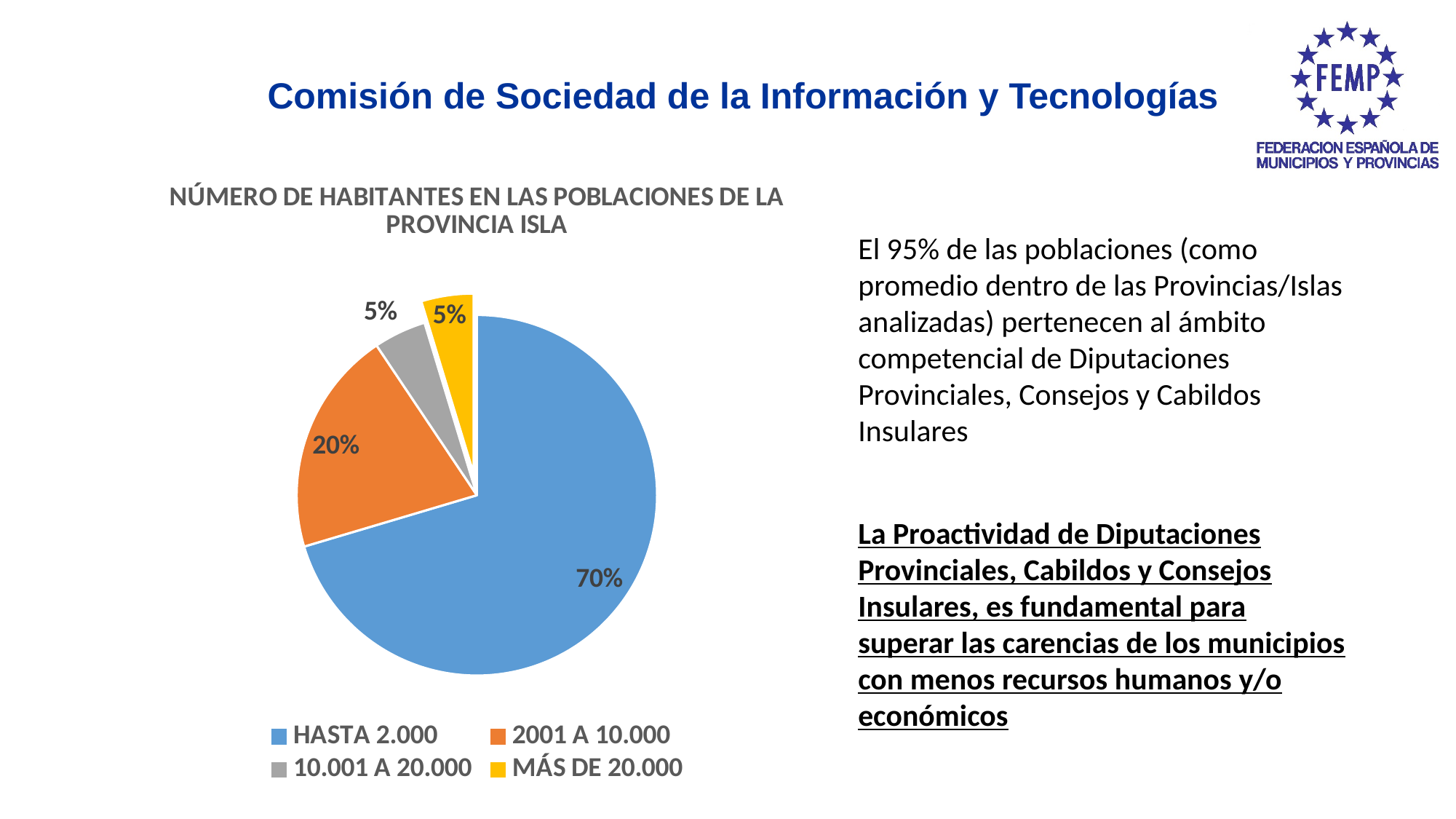
What kind of chart is shown on the slide? Pie chart What is the combined share of HASTA 2.000 and 2001 A 10.000? 90% What share of the pie does 2001 A 10.000 represent? 20% What share of the pie does HASTA 2.000 represent? 70% How many categories does the legend list? 4 What share of the pie does 10.001 A 20.000 represent? 5% Which colour represents MÁS DE 20.000 in the pie chart? Yellow Which is larger, the share for 2001 A 10.000 or the share for MÁS DE 20.000? 2001 A 10.000 What is the title of the chart? NÚMERO DE HABITANTES EN LAS POBLACIONES DE LA PROVINCIA ISLA Which category has the largest slice of the pie? HASTA 2.000 What is the difference between the shares of HASTA 2.000 and 2001 A 10.000? 50%